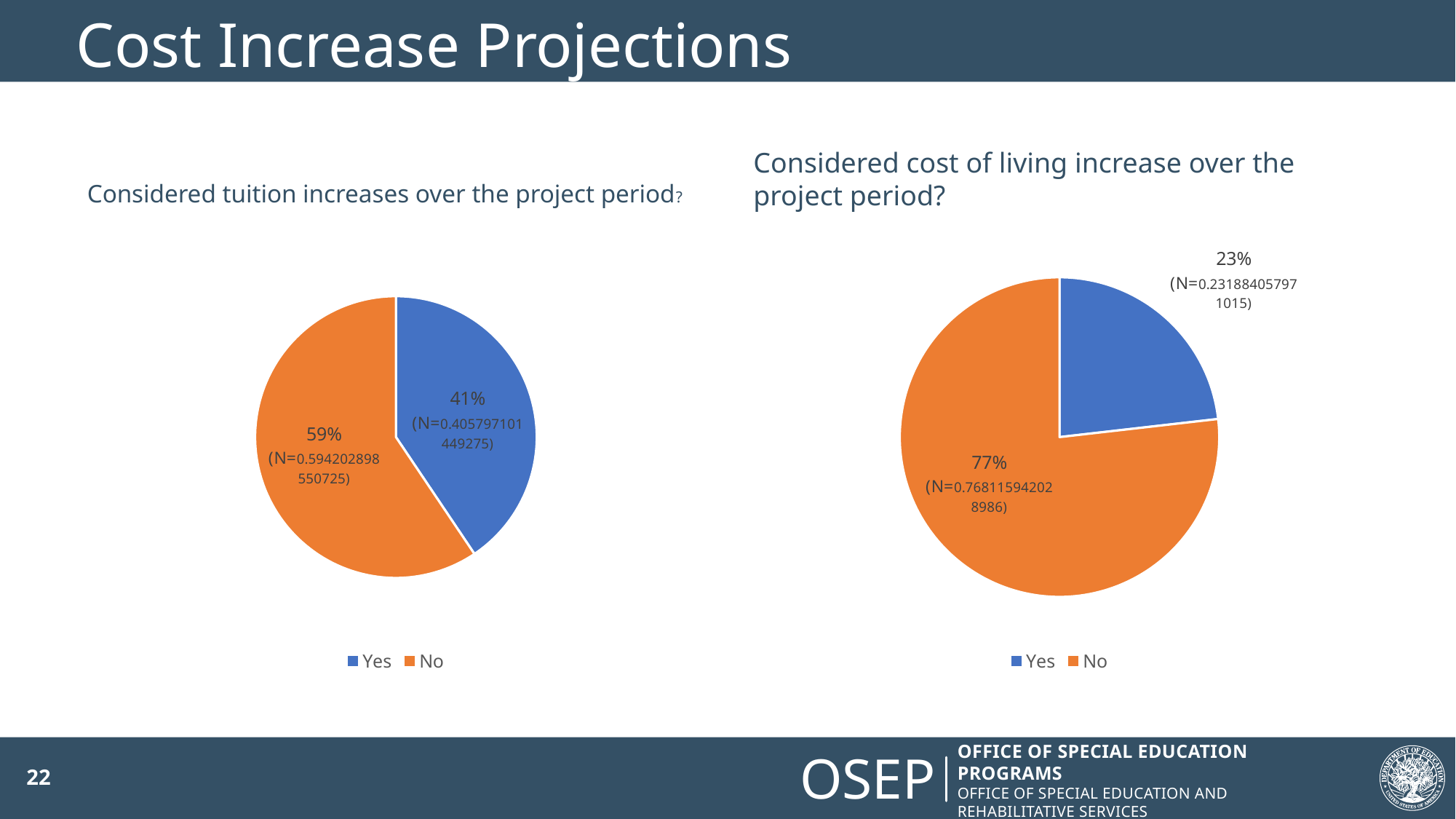
In the right pie chart (cost of living increase), what is the difference in percentage points between No and Yes? 54 In the left pie chart (tuition increases), what is the difference in percentage points between No and Yes? 18 In the right pie chart (cost of living increase), what percentage answered Yes? 23% In the left pie chart (tuition increases), what percentage answered No? 59% In the left pie chart (tuition increases), which response has the larger share? No In the left pie chart (tuition increases), what percentage answered Yes? 41% In the right pie chart (cost of living increase), which response has the smaller share? Yes What type of chart is used on this slide? Pie chart How many entries does the legend of the left pie chart list? 2 In the right pie chart (cost of living increase), which colour represents No? Orange Is the Yes share larger in the left pie chart (tuition increases) or the right pie chart (cost of living increase)? Left (tuition increases) In the right pie chart (cost of living increase), what percentage answered No? 77%